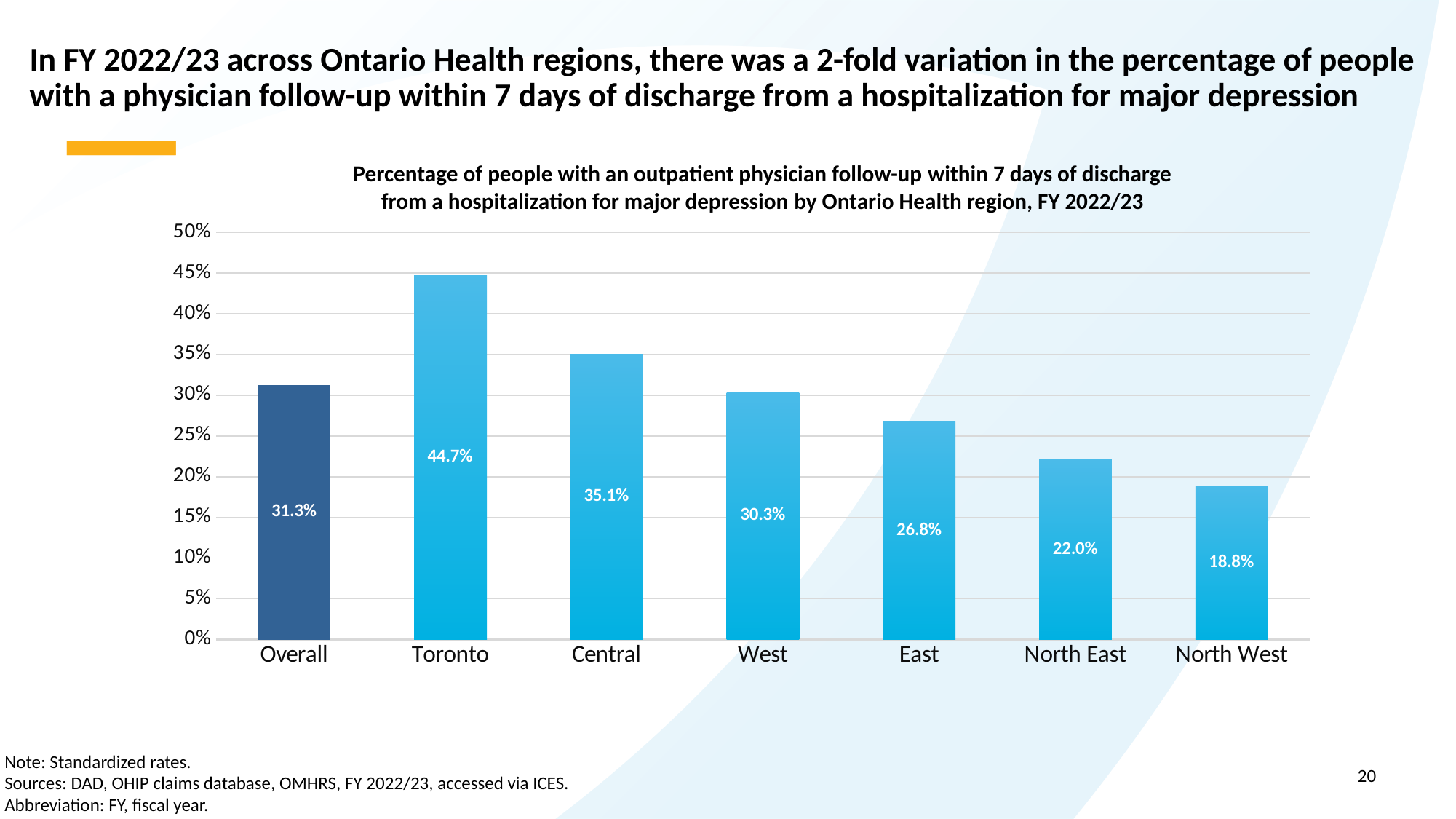
Which region has the highest percentage of follow-up within 7 days? Toronto Which region has the lowest percentage of follow-up within 7 days? North West Which is larger, the value for West or the value for East? West What kind of chart is shown on the slide? Bar chart How many bars are shown in the chart? 7 What is the value for the East region? 26.8% What is the value shown for the Overall bar? 31.3% Is the value for North East greater or less than 25%? less What is the difference between the Central and West values? 4.8% What is the difference between the Toronto and North West values? 25.9% What is the value for the North West region? 18.8% What is the percentage of people with an outpatient physician follow-up within 7 days for Toronto? 44.7%